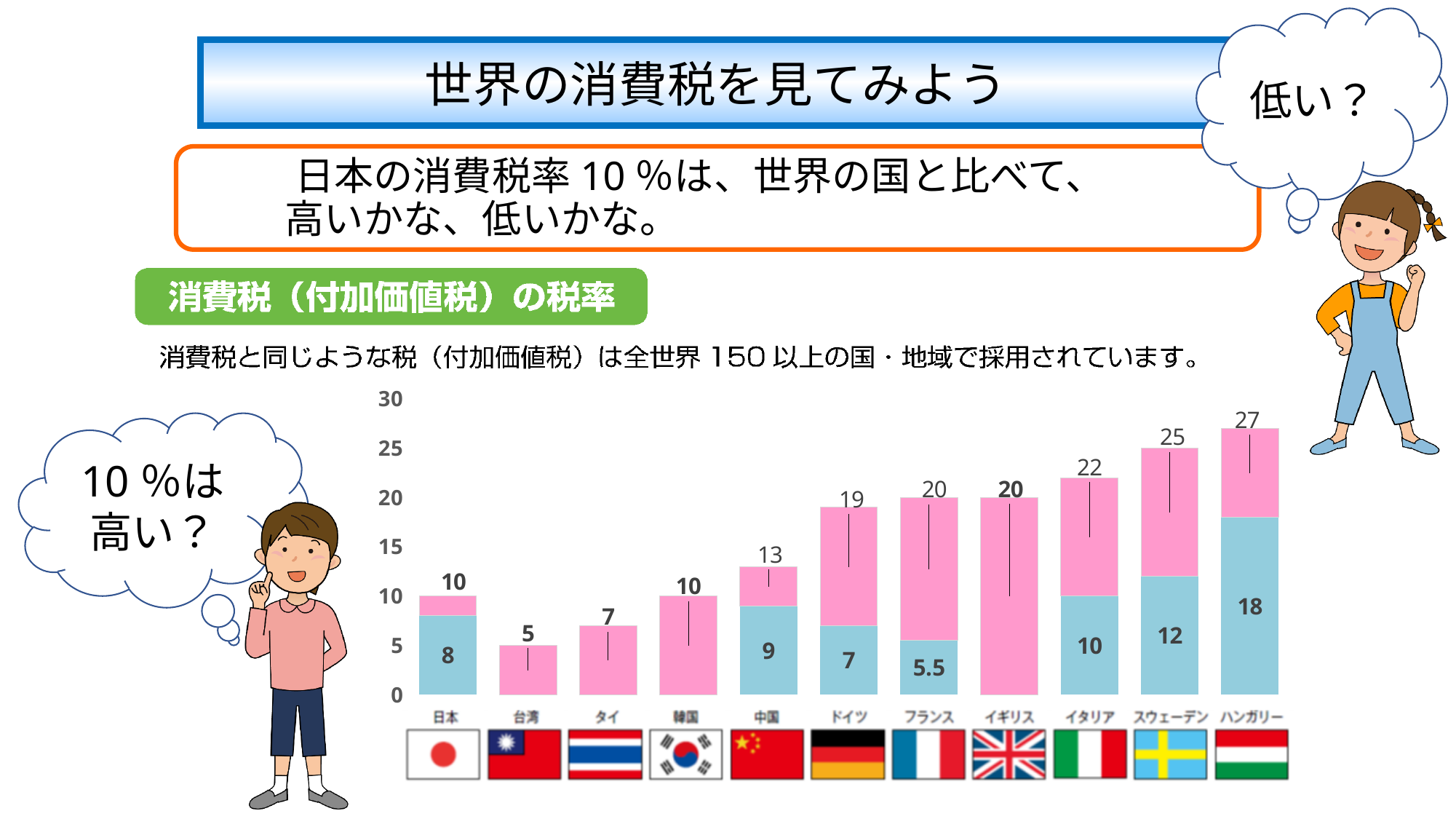
What is the highest value shown on the vertical axis of the chart? 30 What value is printed inside the blue portion of the bar for フランス (France)? 5.5 What value is printed inside the blue portion of the bar for 日本 (Japan)? 8 What kind of chart is used to show the tax rates? bar chart How many countries or regions are shown on the x axis of the chart? 11 Which country has the lowest standard rate in the chart? 台湾 What is the standard consumption tax rate shown for ハンガリー (Hungary)? 27 What is the standard consumption tax rate shown for 台湾 (Taiwan)? 5 Do the standard rates generally rise or fall from left to right along the x axis? rise What is the difference between the standard rates of スウェーデン (Sweden) and 日本 (Japan)? 15 Which has a higher standard rate, ドイツ (Germany) or 中国 (China)? ドイツ Which country has the highest standard rate in the chart? ハンガリー